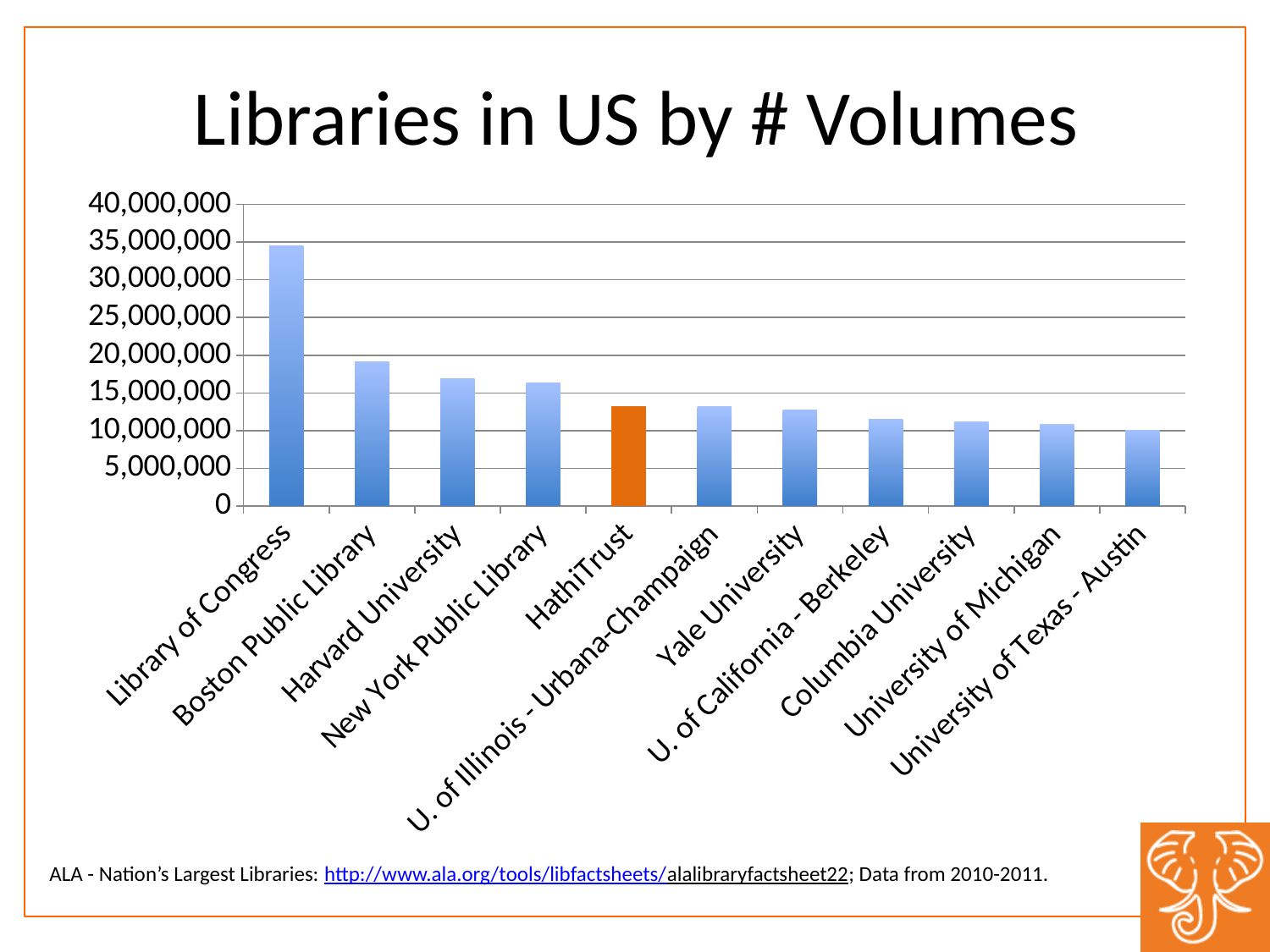
Which has more volumes, Boston Public Library or New York Public Library? Boston Public Library Is the value for Boston Public Library greater or less than 20,000,000? less Is the value for Yale University greater or less than 10,000,000? greater Is the value for Harvard University greater or less than 15,000,000? greater Do the values generally rise or fall from left to right across the chart? Fall Which has more volumes, Harvard University or Yale University? Harvard University Which library's bar is highlighted in orange? HathiTrust What type of chart is shown on the slide? Bar chart How many libraries are shown in the chart? 11 Which library has the highest number of volumes in the chart? Library of Congress